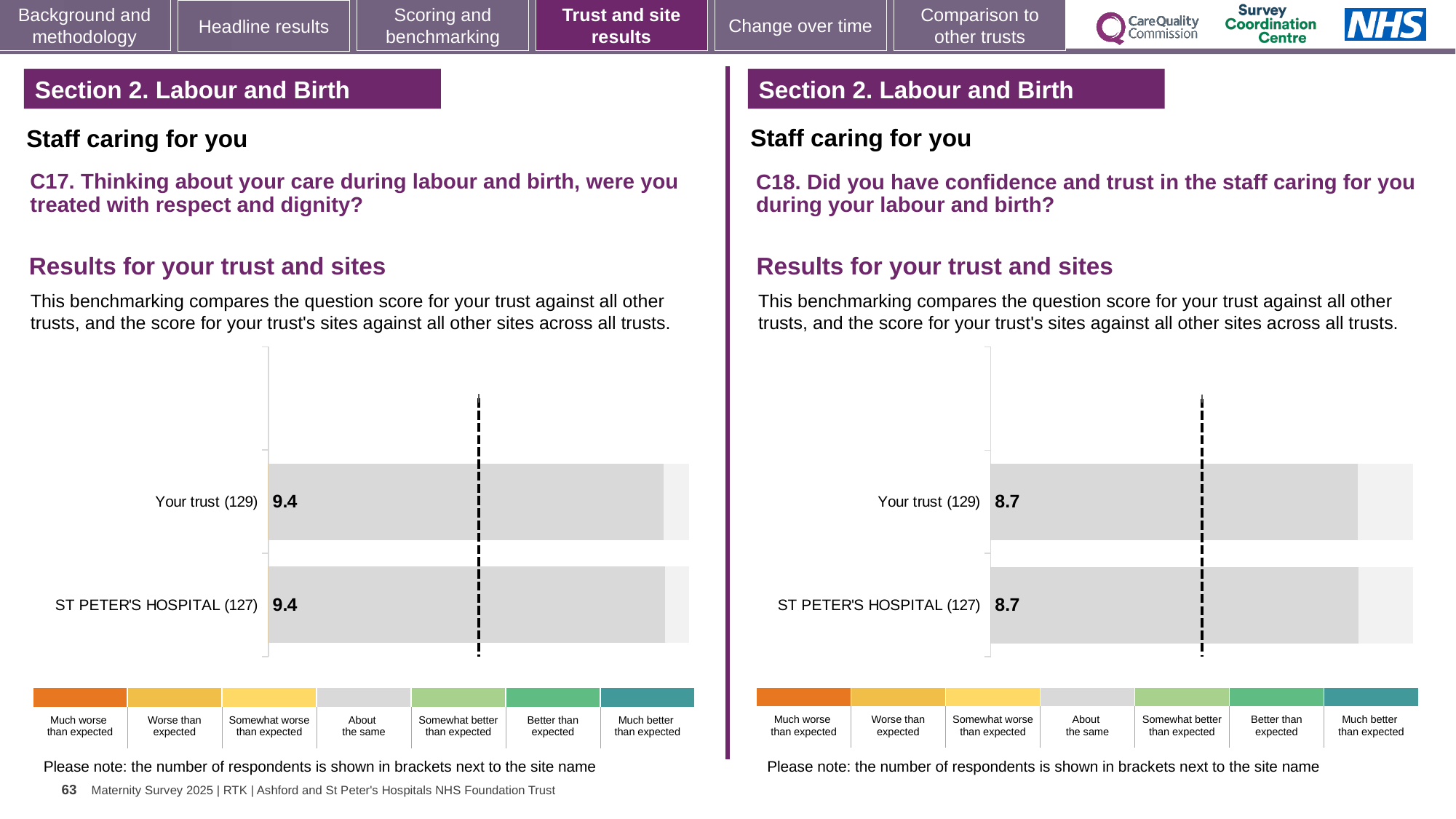
In the C18 chart on the right, what is the difference between the score for Your trust and the score for ST PETER'S HOSPITAL? 0 How many bars are plotted in the C17 chart on the left? 2 In the C18 chart on the right, what is the score for ST PETER'S HOSPITAL (127)? 8.7 In the C17 chart on the left, what is the score for ST PETER'S HOSPITAL (127)? 9.4 Is the score for Your trust in the C17 chart on the left larger than the score for Your trust in the C18 chart on the right? Yes How many categories does the colour legend below the C17 chart on the left list? 7 In the C17 chart on the left, what is the difference between the score for Your trust and the score for ST PETER'S HOSPITAL? 0 How many respondents are shown in brackets for ST PETER'S HOSPITAL in the C18 chart on the right? 127 How many bars are plotted in the C18 chart on the right? 2 What type of chart is used for the C17 results on the left? Bar chart In the C17 chart on the left, what is the score for Your trust (129)? 9.4 In the C18 chart on the right, what is the score for Your trust (129)? 8.7